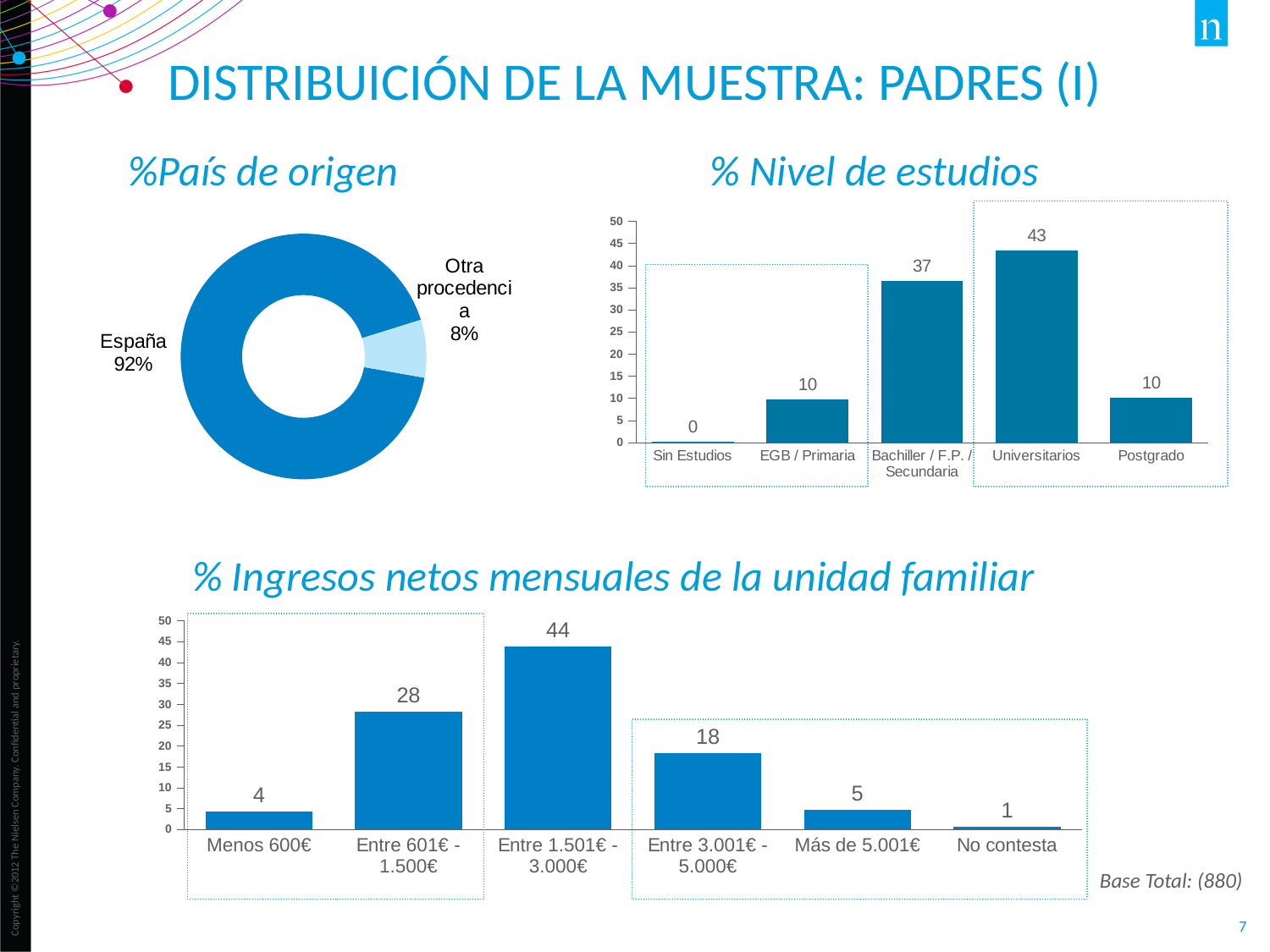
In the '% Nivel de estudios' chart, which category has the highest value? Universitarios In the '% Nivel de estudios' chart, which category has the lowest value? Sin Estudios In the '% Ingresos netos mensuales de la unidad familiar' chart, what is the value for 'Entre 1.501€ - 3.000€'? 44 In the '% Ingresos netos mensuales de la unidad familiar' chart, which category has the lowest value? No contesta In the '%País de origen' chart, what share of the sample is from España? 92% In the '% Nivel de estudios' chart, what is the value for Universitarios? 43 What kind of chart is the '%País de origen' chart? Doughnut chart In the '% Ingresos netos mensuales de la unidad familiar' chart, what is the difference between 'Entre 1.501€ - 3.000€' and 'Entre 601€ - 1.500€'? 16 How many categories are shown in the '% Nivel de estudios' chart? 5 In the '%País de origen' chart, what share is 'Otra procedencia'? 8% In the '% Ingresos netos mensuales de la unidad familiar' chart, which is larger: 'Entre 601€ - 1.500€' or 'Entre 3.001€ - 5.000€'? Entre 601€ - 1.500€ In the '% Nivel de estudios' chart, what is the difference between Universitarios and Bachiller / F.P. / Secundaria? 6